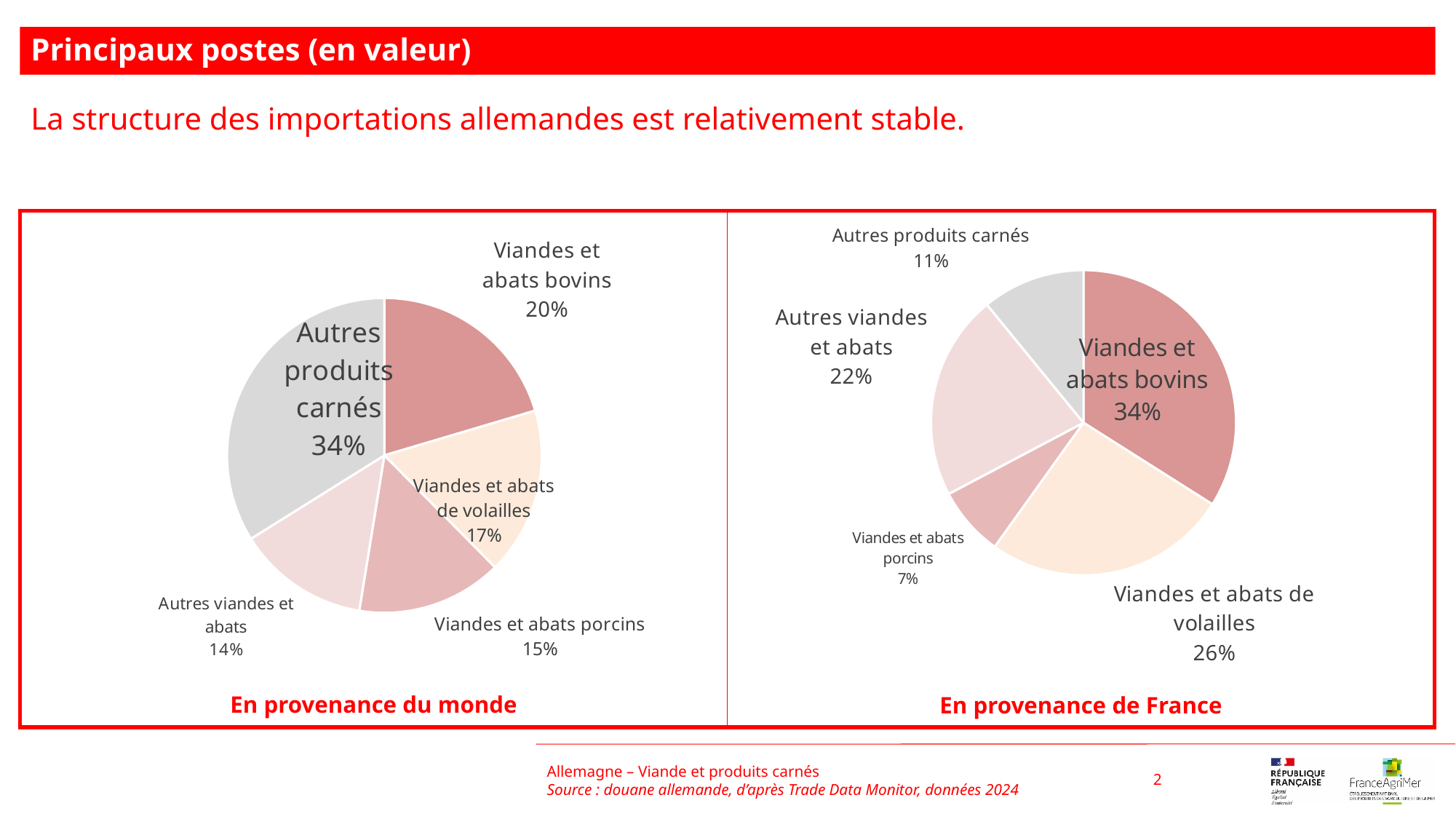
In the 'En provenance du monde' pie chart, which category has the largest share? Autres produits carnés What type of chart is used on the slide? Pie chart In the 'En provenance du monde' pie chart, what is the difference between the shares of 'Viandes et abats bovins' and 'Autres viandes et abats'? 6 percentage points In the 'En provenance de France' pie chart, what share is 'Autres viandes et abats'? 22% In the 'En provenance de France' pie chart, which category has the smallest share? Viandes et abats porcins In the 'En provenance du monde' pie chart, what share is 'Viandes et abats bovins'? 20% What is the title of the chart on the right side of the slide? En provenance de France In the 'En provenance de France' pie chart, which is larger: 'Viandes et abats de volailles' or 'Autres viandes et abats'? Viandes et abats de volailles In the 'En provenance du monde' pie chart, what share is 'Viandes et abats de volailles'? 17% How many slices does the 'En provenance du monde' pie chart have? 5 In the 'En provenance de France' pie chart, what share is 'Viandes et abats porcins'? 7% In the 'En provenance de France' pie chart, which category has the largest share? Viandes et abats bovins